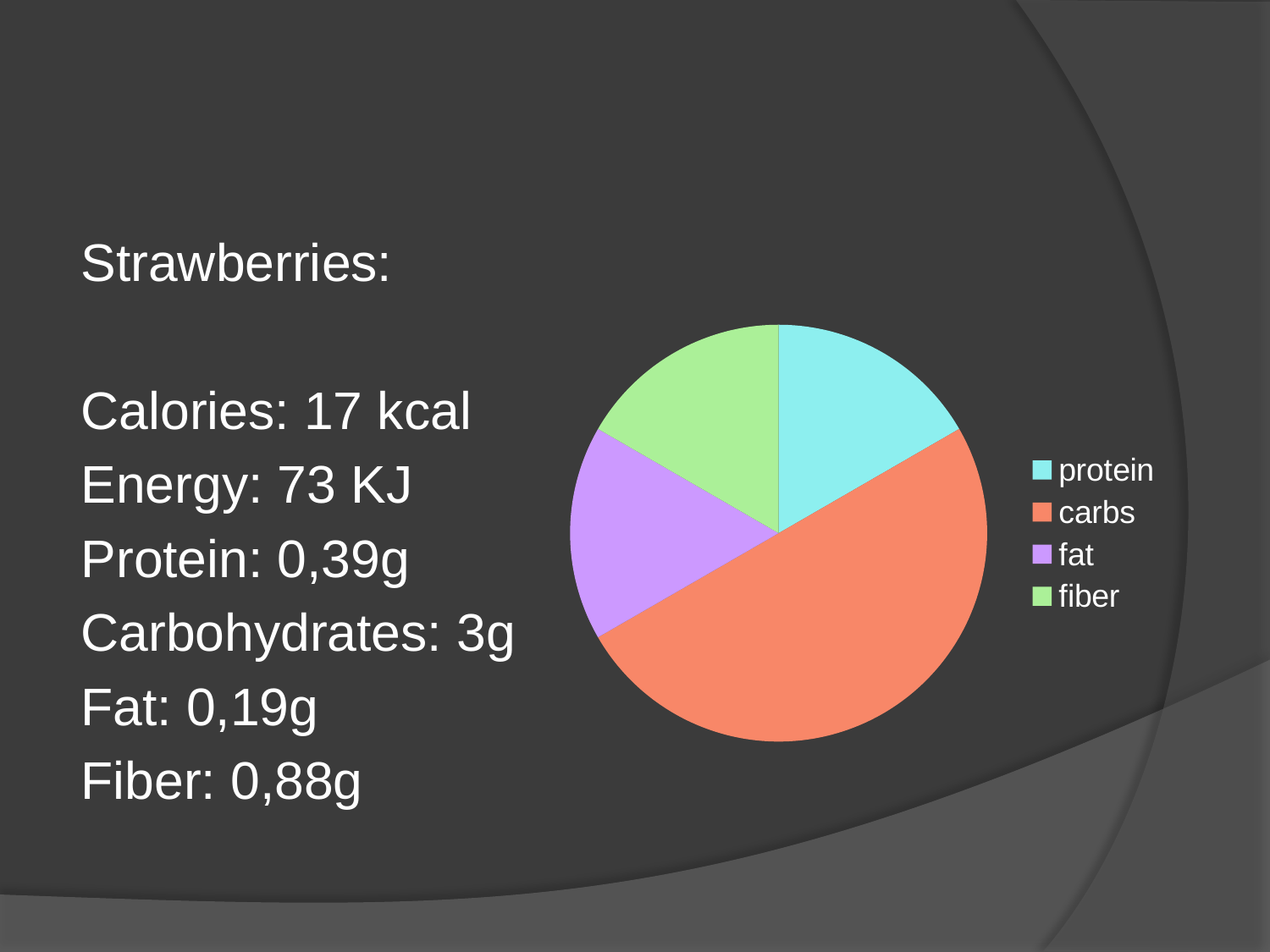
What kind of chart is shown on the slide? pie chart How many slices does the pie chart have? 4 Which slice is larger in the pie chart, carbs or fiber? carbs Which category has the largest slice in the pie chart? carbs Which category is shown in green in the pie chart? fiber How many entries does the legend of the pie chart list? 4 Which slice is larger in the pie chart, carbs or fat? carbs Which slice is larger in the pie chart, carbs or protein? carbs What colour is the carbs slice in the pie chart? orange